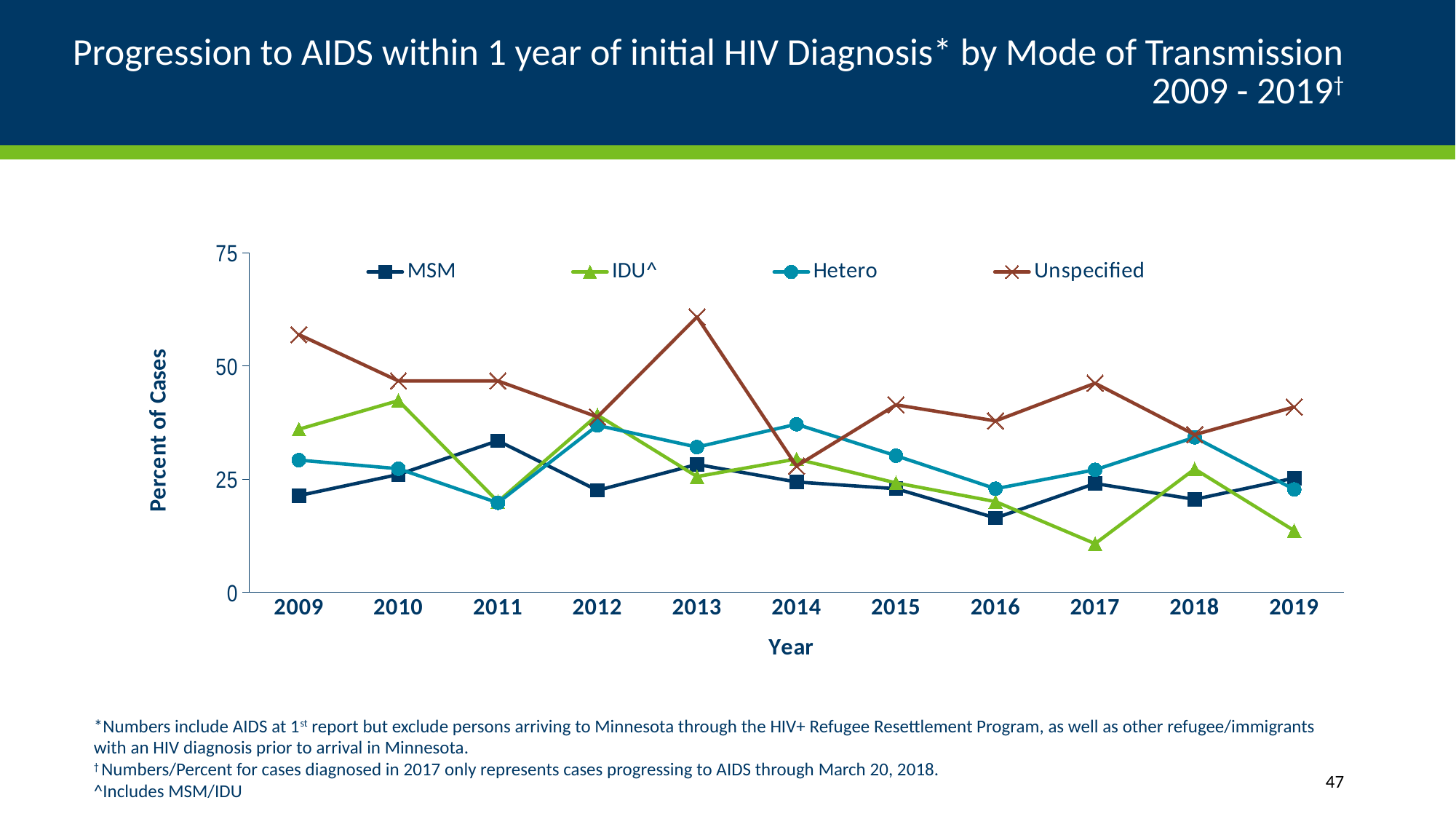
Which series has the highest value in 2009? Unspecified In which year does the Unspecified series reach its highest value? 2013 In which year does the IDU^ series reach its lowest value? 2017 Is the value for IDU^ in 2017 greater or less than 25? less In 2009, which is larger: the value for Unspecified or the value for MSM? Unspecified Is the value for MSM in 2016 greater or less than 25? less Is the value for Unspecified in 2013 greater or less than 50? greater What is the label on the y axis? Percent of Cases How many years are plotted along the x axis? 11 Which series has the lowest value in 2019? IDU^ What kind of chart is shown on the slide? line chart How many series does the legend list? 4